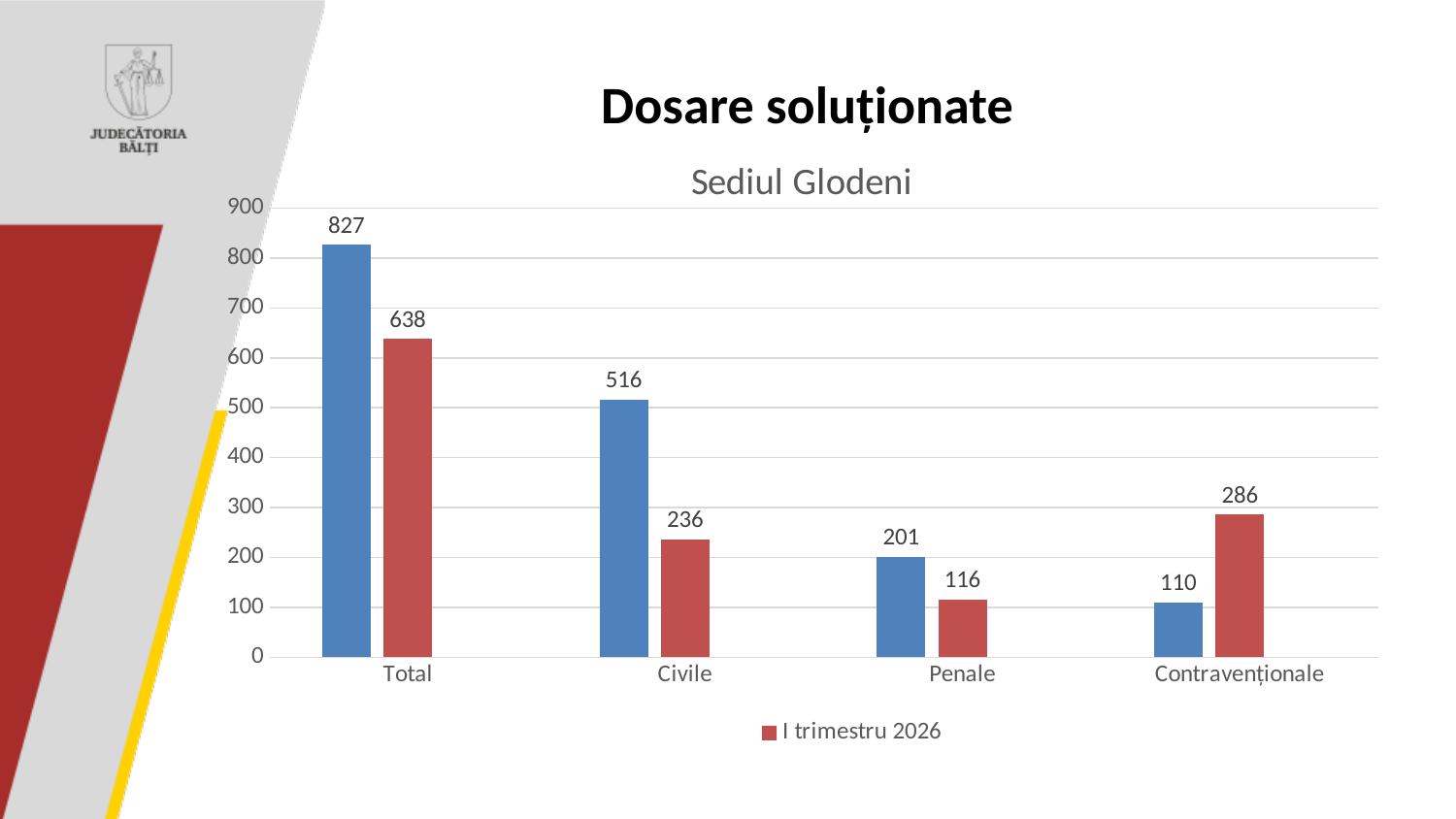
Which category has the lowest value in the 'I trimestru 2026' series? Penale For Contravenționale, which is larger: the blue bar or the red 'I trimestru 2026' bar? The red 'I trimestru 2026' bar What kind of chart is shown on the slide? Bar chart Which category has the highest blue bar? Total How many categories are shown on the x axis? 4 What is the difference between the blue bar and the red 'I trimestru 2026' bar for Total? 189 Is the value of the red 'I trimestru 2026' bar for Total greater or less than 600? greater What is the value of the blue bar for Total? 827 What is the value of the red 'I trimestru 2026' bar for Civile? 236 What is the value of the red 'I trimestru 2026' bar for Contravenționale? 286 What is the value of the blue bar for Penale? 201 What is the subtitle shown above the chart? Sediul Glodeni